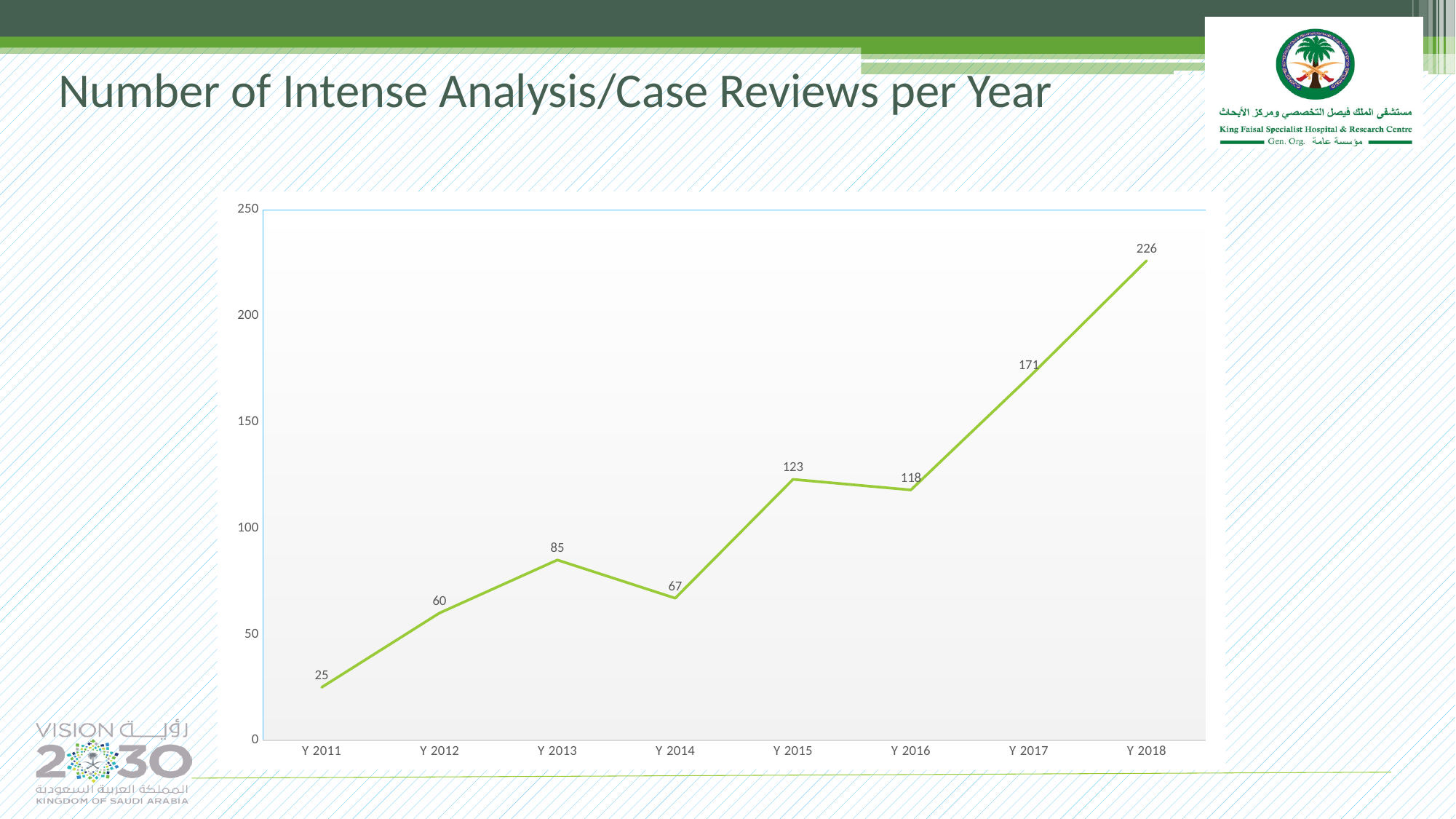
What is the title of the slide? Number of Intense Analysis/Case Reviews per Year What is the value for Y 2017? 171 Is the value for Y 2017 greater or less than 150? greater What is the number of intense analysis/case reviews in Y 2011? 25 What is the difference between the values for Y 2018 and Y 2017? 55 Which is larger, the value for Y 2015 or the value for Y 2016? Y 2015 What kind of chart is shown on the slide? line chart What is the value for Y 2015? 123 What is the difference between the values for Y 2013 and Y 2014? 18 Which year has the highest number of case reviews? Y 2018 How many years are plotted on the chart? 8 Which year has the lowest number of case reviews? Y 2011